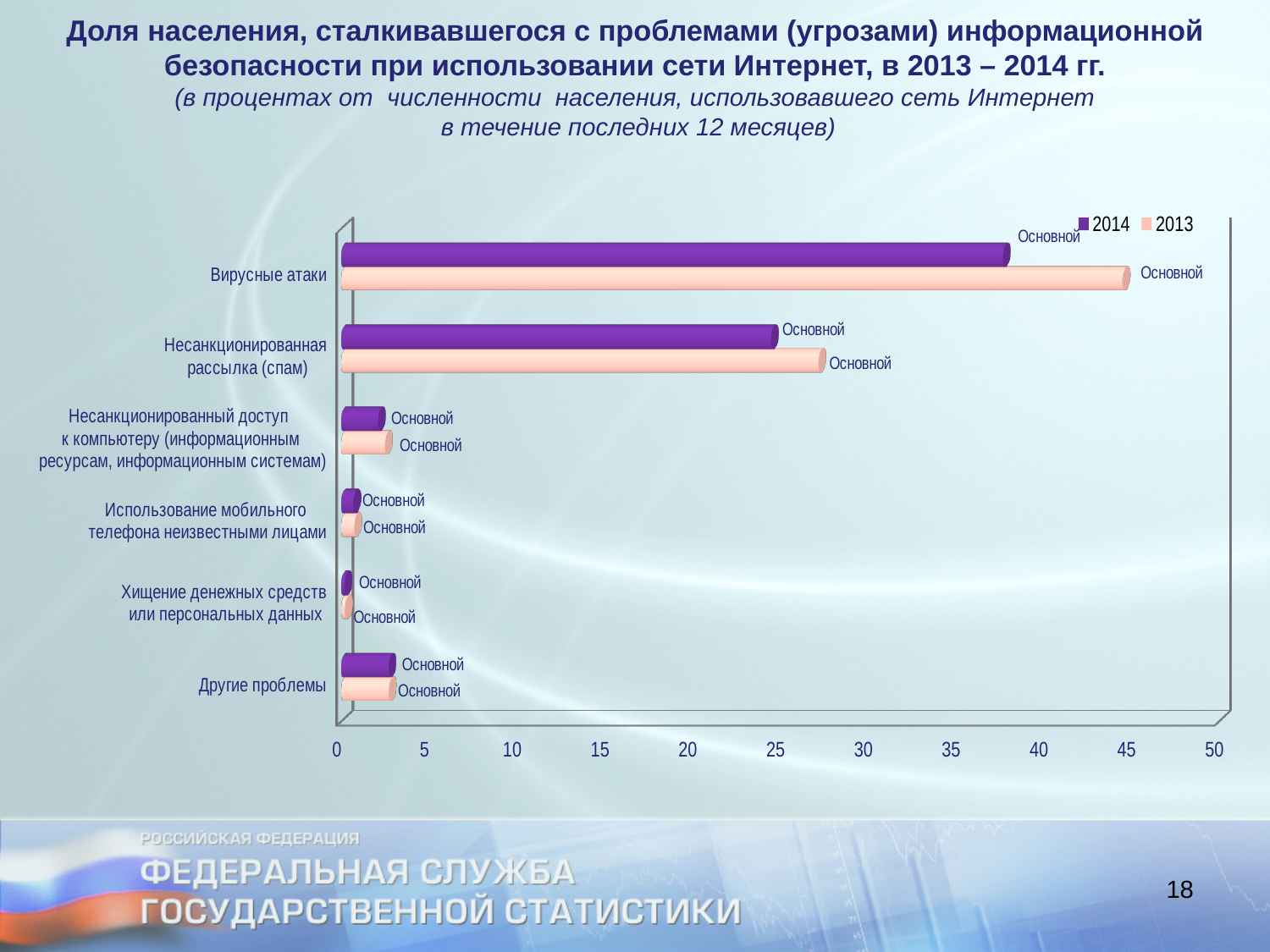
Is the 2014 value for Несанкционированная рассылка (спам) greater or less than 30? less Which category has the highest value for 2014? Вирусные атаки For Вирусные атаки, which year has the larger value, 2013 or 2014? 2013 Which series is shown in purple in the legend? 2014 For 2014, which is larger: Вирусные атаки or Несанкционированная рассылка (спам)? Вирусные атаки How many categories (types of problems) are shown on the chart? 6 Which category has the highest value for 2013? Вирусные атаки What kind of chart is shown on the slide? bar chart Is the 2013 value for Несанкционированный доступ к компьютеру greater or less than 10? less Is the 2013 value for Вирусные атаки greater or less than 40? greater How many series does the legend list? 2